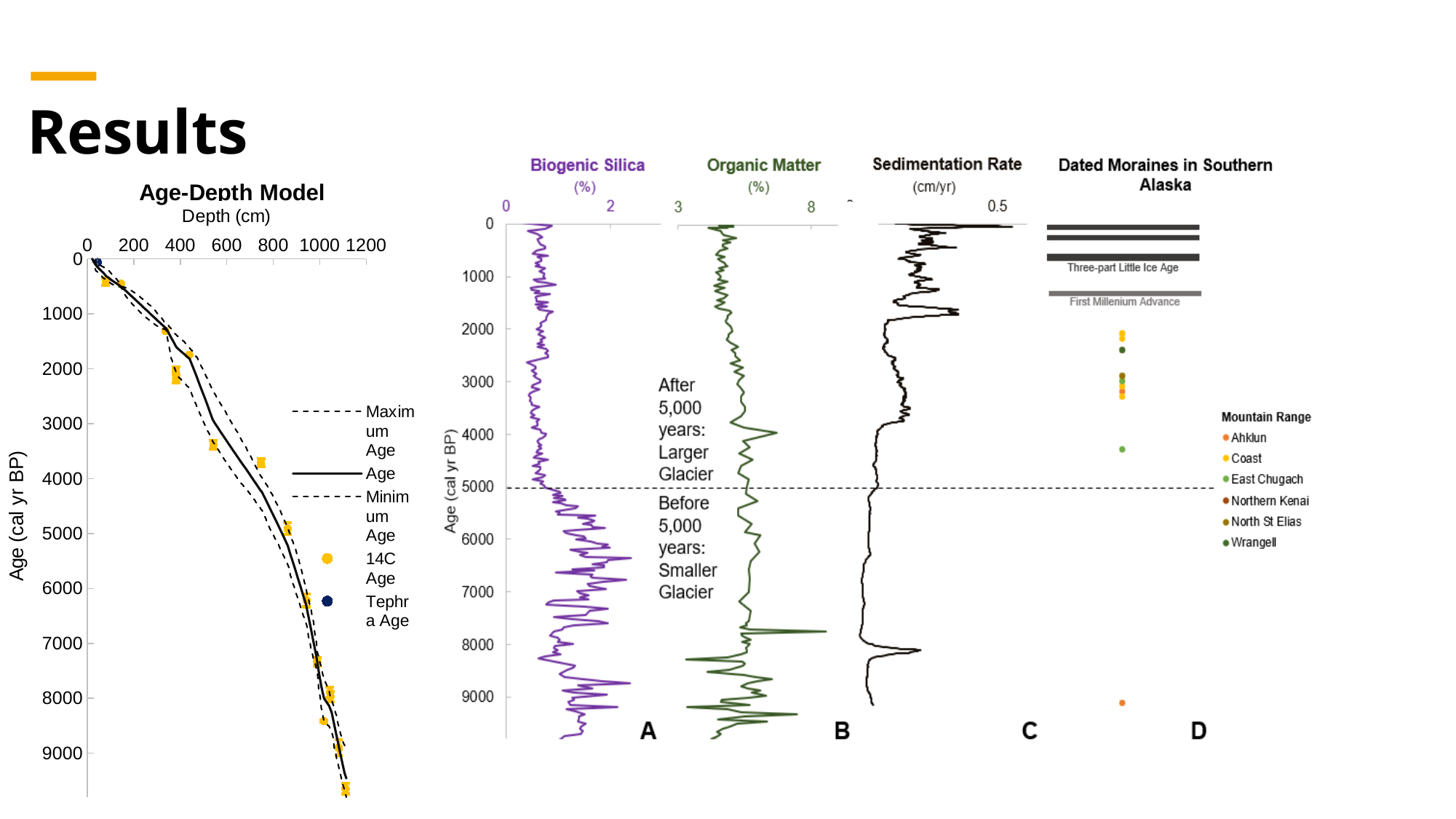
What type of chart is the Age-Depth Model on the left of the slide? line chart In the Sedimentation Rate panel (C), is the sedimentation rate near 0 cal yr BP greater or less than the rate near 7000 cal yr BP? greater How many entries does the legend of the Age-Depth Model chart list? 5 In the Biogenic Silica panel (A), are values generally higher before or after 5,000 years? before In the Age-Depth Model chart, is the depth at an age of 1000 cal yr BP greater or less than 600 cm? less In the Dated Moraines in Southern Alaska panel, how many mountain ranges does the legend list? 6 How many lettered panels (A, B, C, D) does the right-hand figure contain? 4 In the Dated Moraines in Southern Alaska panel, which mountain range has the oldest dated moraine (the point plotted lowest, near 9000 cal yr BP)? Ahklun What is the x-axis title of the Age-Depth Model chart? Depth (cm) In the Age-Depth Model chart, is the depth at an age of 5000 cal yr BP greater or less than 800 cm? greater In the right-hand figure, at what age (cal yr BP) is the horizontal dashed line drawn? 5000 In the Age-Depth Model chart, does age increase or decrease as depth increases? increase